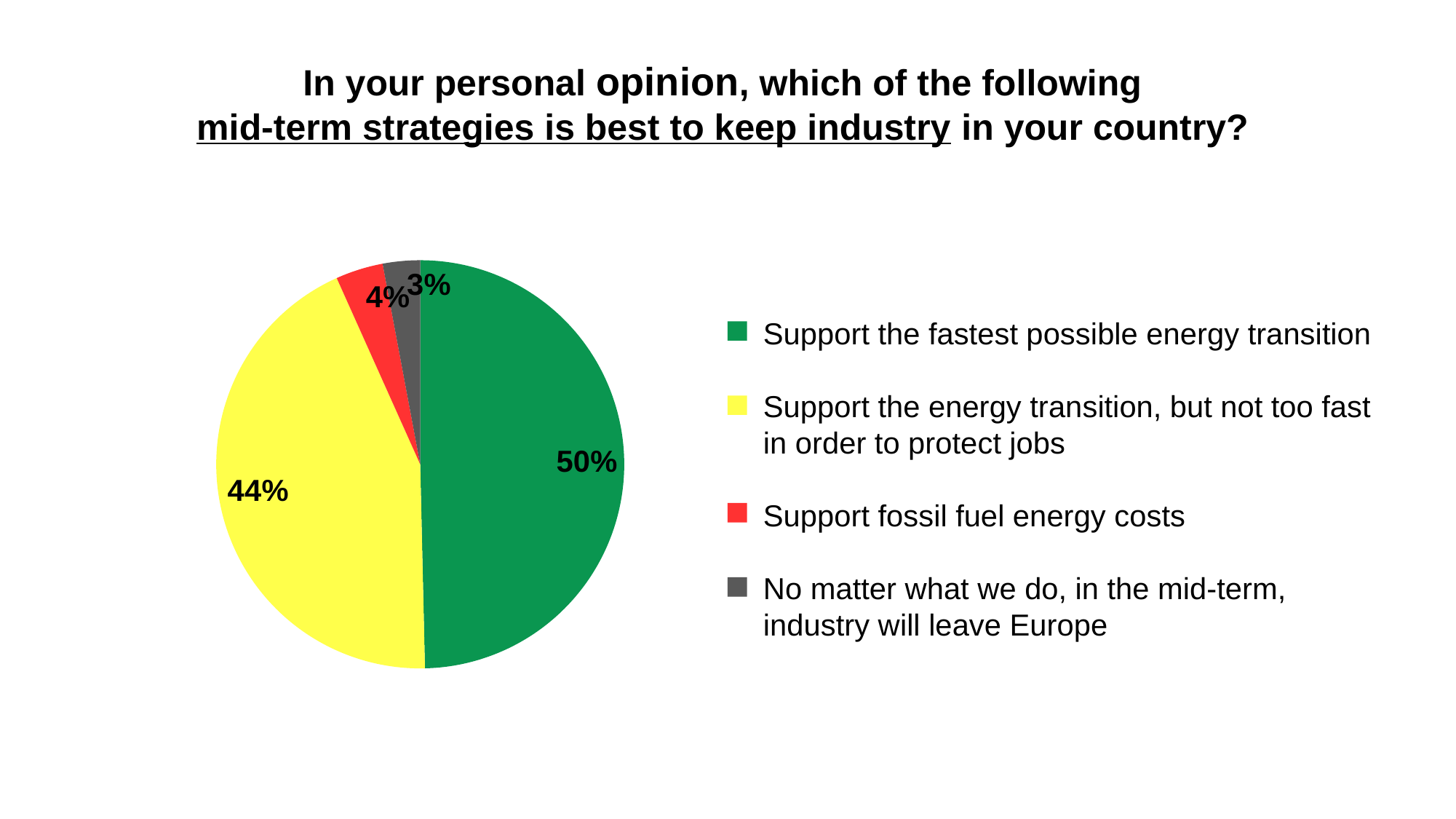
Which option has the smallest share of the pie? No matter what we do, in the mid-term, industry will leave Europe Which option has the largest share of the pie? Support the fastest possible energy transition What share of respondents chose 'Support the fastest possible energy transition'? 50% Which option is represented by the yellow slice? Support the energy transition, but not too fast in order to protect jobs What kind of chart is shown on the slide? Pie chart What share of respondents chose 'Support the energy transition, but not too fast in order to protect jobs'? 44% What colour is the slice for 'Support fossil fuel energy costs'? Red How many slices does the pie chart have? 4 What share of respondents chose 'Support fossil fuel energy costs'? 4% Which is larger: the share for 'Support fossil fuel energy costs' or the share for 'No matter what we do, in the mid-term, industry will leave Europe'? Support fossil fuel energy costs What share of respondents chose 'No matter what we do, in the mid-term, industry will leave Europe'? 3% What is the difference in percentage points between 'Support the fastest possible energy transition' and 'Support the energy transition, but not too fast in order to protect jobs'? 6 percentage points